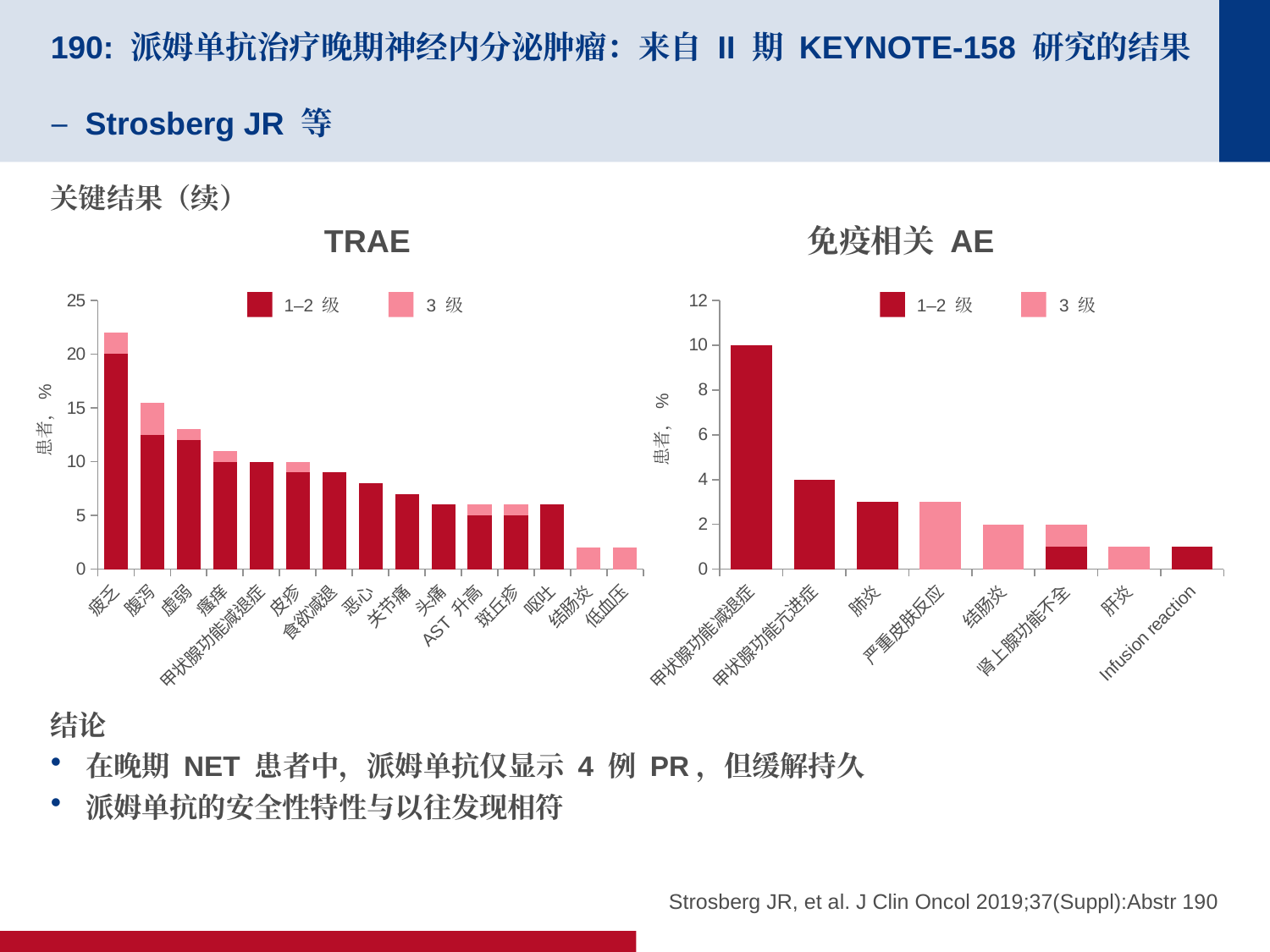
In the TRAE chart, how many adverse event categories are shown on the x axis? 15 In the 免疫相关 AE chart, how many categories are shown on the x axis? 8 In the TRAE chart, is the value for 恶心 greater or less than 10? less In the TRAE chart, which has a larger total value, 腹泻 or 虚弱? 腹泻 In the 免疫相关 AE chart, which adverse event has the highest percentage of patients? 甲状腺功能减退症 In the TRAE chart, which adverse event has the highest total percentage of patients? 疲乏 What kind of chart is the TRAE chart on the left? bar chart In the 免疫相关 AE chart, what percentage of patients had 甲状腺功能减退症? 10 In the TRAE chart, do the total values generally rise or fall from left to right along the x axis? fall In the TRAE chart, is the total value for 疲乏 greater or less than 20? greater How many series does the legend of the 免疫相关 AE chart list? 2 In the 免疫相关 AE chart, is the value for 肺炎 greater or less than 2? greater